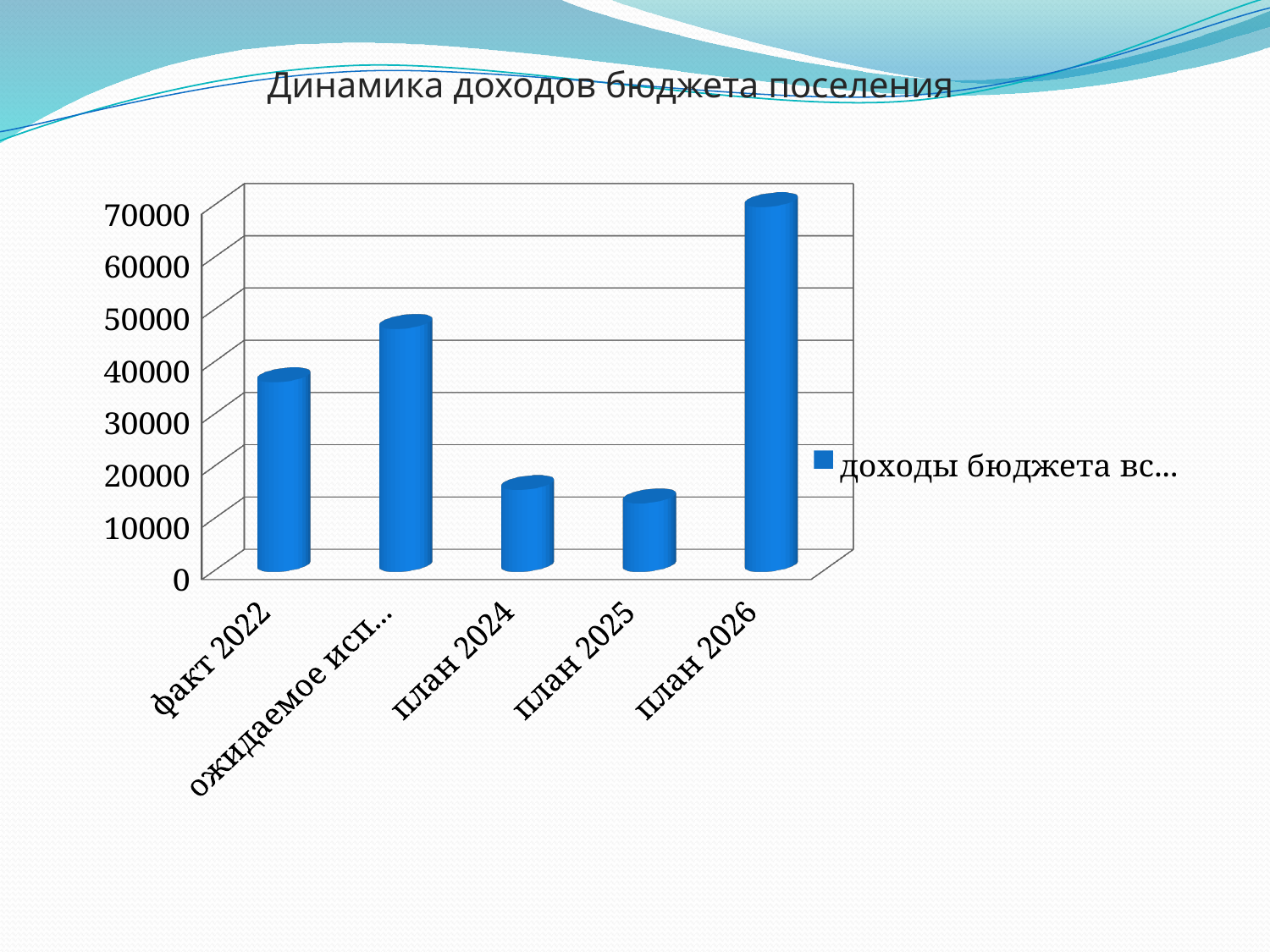
What is the title of the chart? Динамика доходов бюджета поселения How many categories are shown on the x axis of the chart? 5 Does the value rise or fall from план 2025 to план 2026? rise Which is larger, the value for факт 2022 or the value for план 2024? факт 2022 Is the value for план 2024 greater or less than 20000? less Is the value for план 2025 greater or less than 20000? less What type of chart is shown on the slide? bar chart Which category has the highest value? план 2026 Is the value for план 2026 greater or less than 60000? greater Which category has the lowest value? план 2025 How many series does the legend list? 1